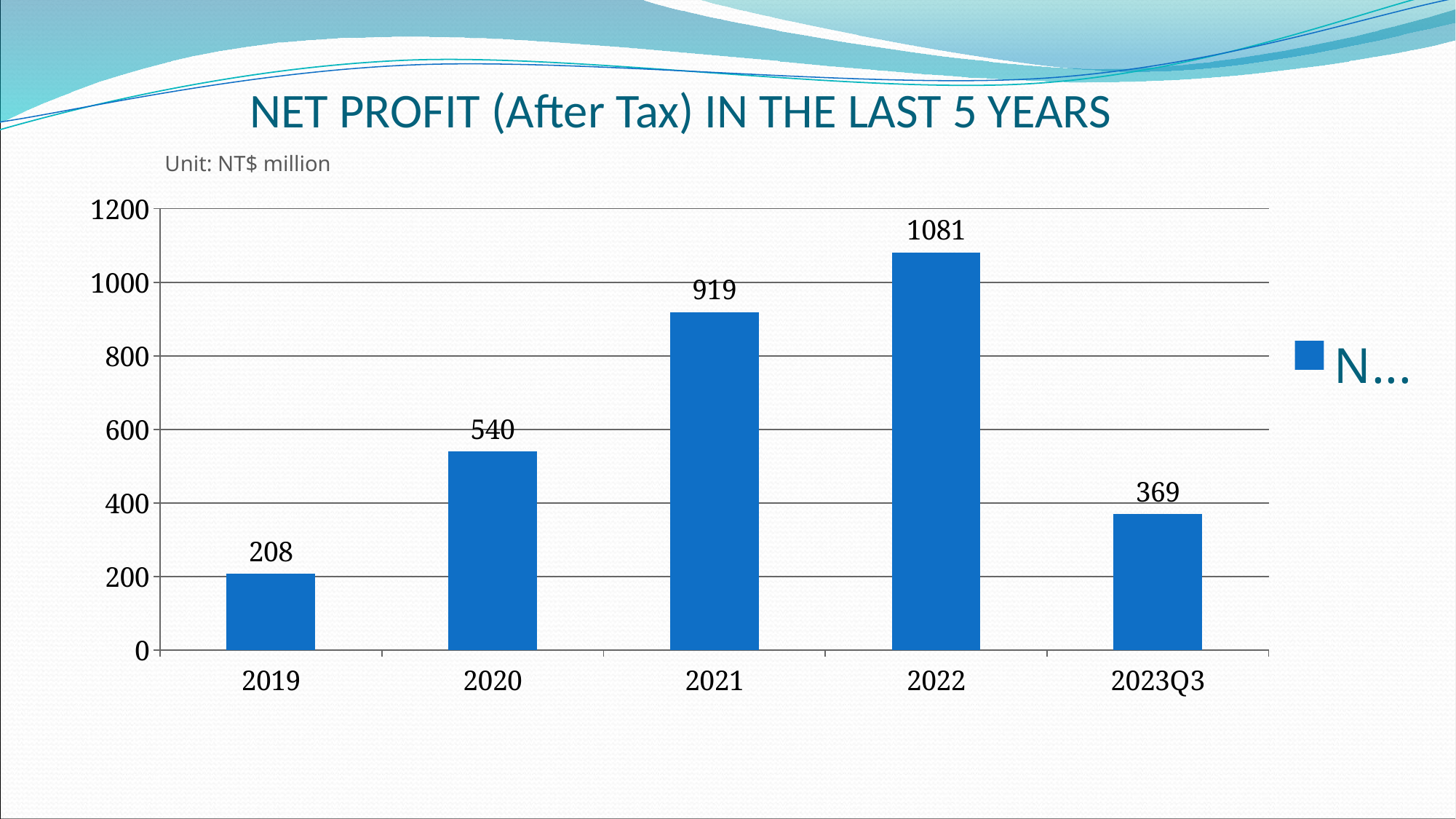
Which year has the highest net profit? 2022 Is the value for 2021 greater or less than 800? greater What is the net profit value for 2021? 919 What is the net profit value for 2023Q3? 369 What is the difference between the net profit in 2022 and in 2021? 162 How many categories are shown on the x axis? 5 What kind of chart is shown on the slide? bar chart What unit is stated for the values in the chart? NT$ million What is the net profit value for 2019? 208 Which category has the lowest net profit? 2019 What is the difference between the net profit in 2020 and in 2019? 332 Which is larger, the net profit for 2020 or for 2023Q3? 2020